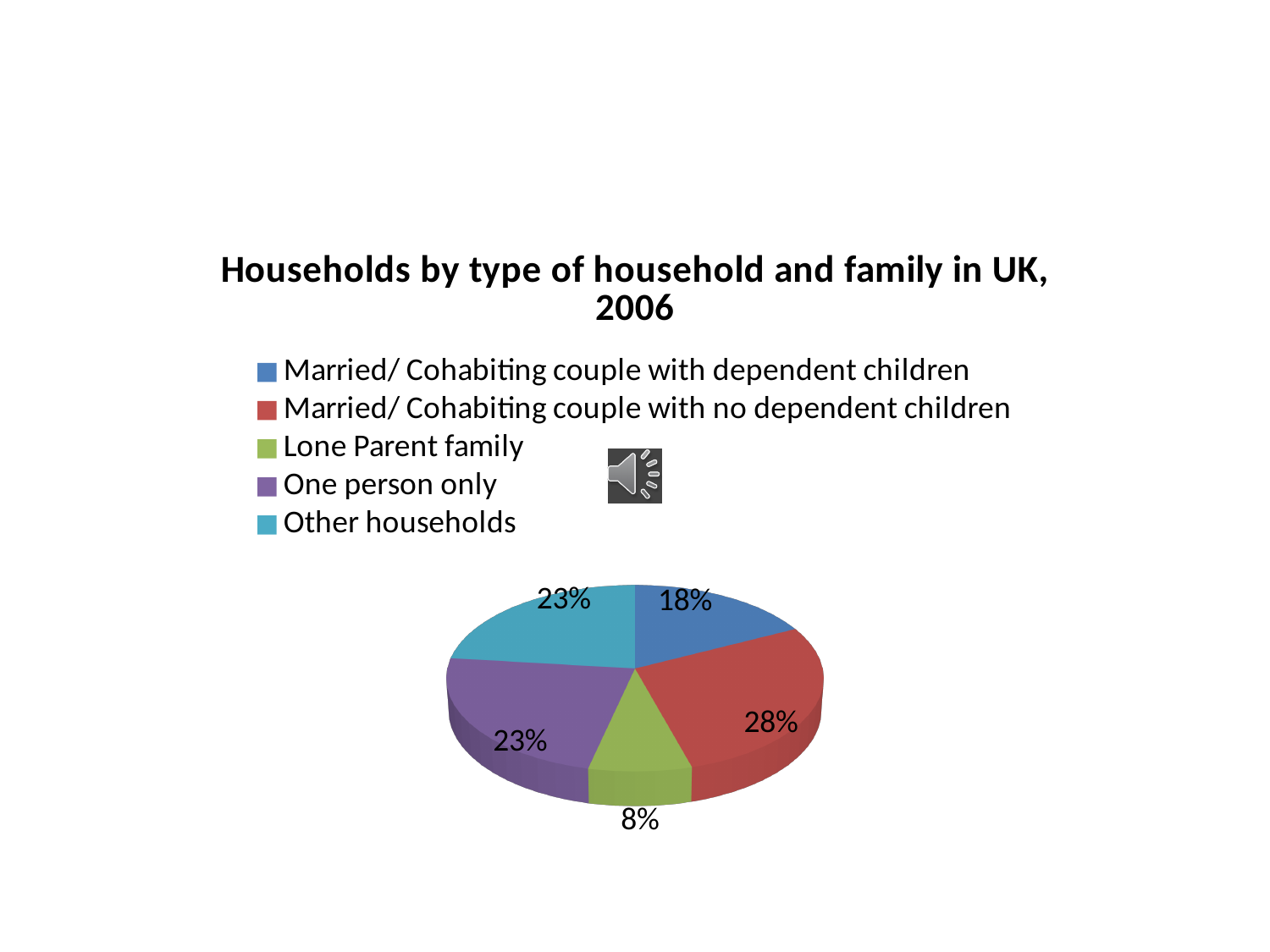
What share of households is One person only? 23% What share of households is Married/ Cohabiting couple with no dependent children? 28% Which is larger: the share for Married/ Cohabiting couple with dependent children or the share for One person only? One person only What share of households is Other households? 23% What share of households is Married/ Cohabiting couple with dependent children? 18% Which household type has the largest share of the pie? Married/ Cohabiting couple with no dependent children What is the title of the chart? Households by type of household and family in UK, 2006 How many household types are shown in the pie chart? 5 What share of households is Lone Parent family? 8% What kind of chart is shown on the slide? Pie chart Which household type has the smallest share of the pie? Lone Parent family What is the difference in percentage points between Married/ Cohabiting couple with no dependent children and Lone Parent family? 20